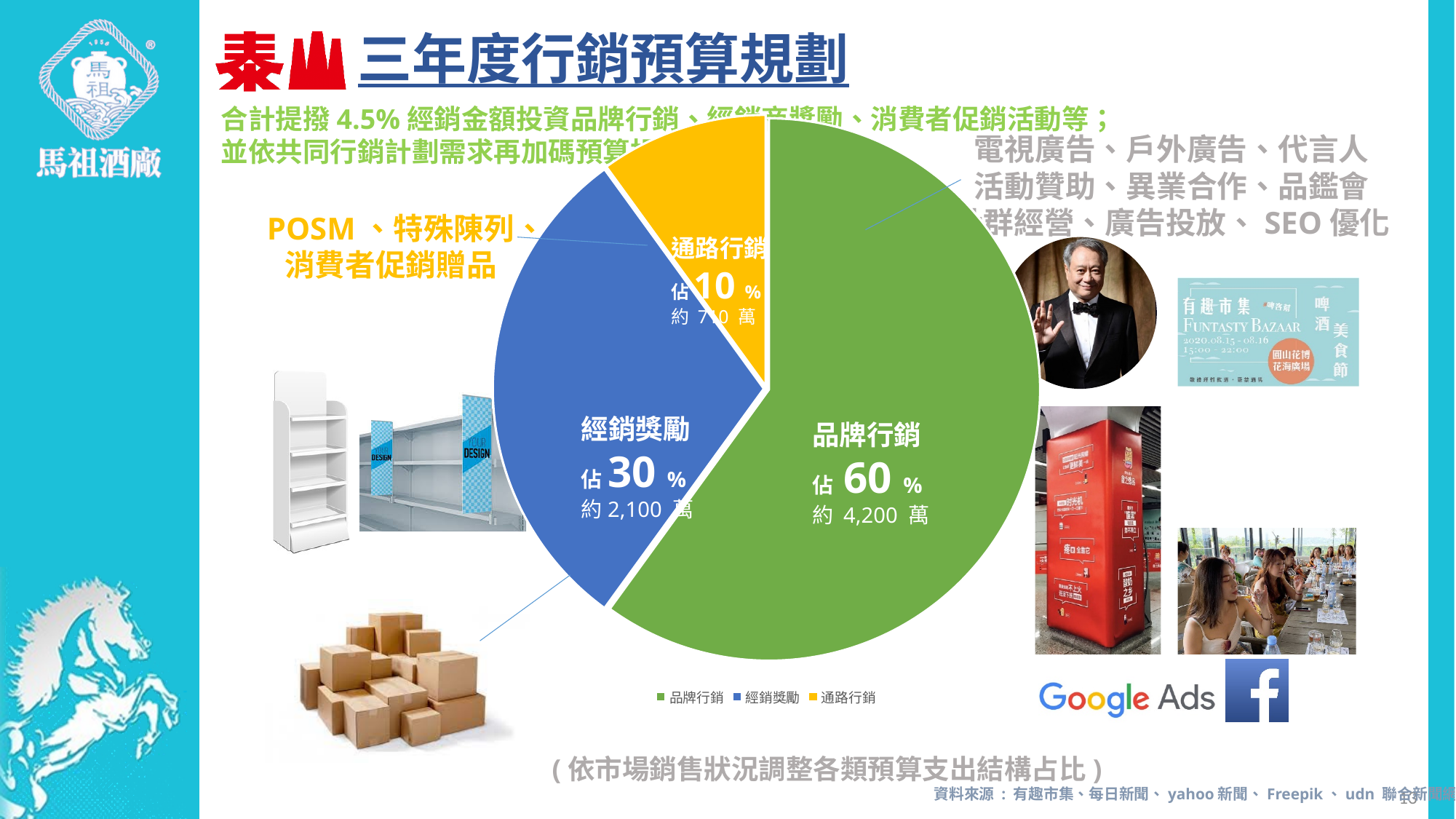
What percentage share does 經銷獎勵 have in the pie chart? 30% What percentage share does 通路行銷 have in the pie chart? 10% What approximate amount is labelled for 品牌行銷 in the pie chart? 約 4,200 萬 What percentage share does 品牌行銷 have in the pie chart? 60% Which category has the largest slice in the pie chart? 品牌行銷 Which slice is larger, 經銷獎勵 or 通路行銷? 經銷獎勵 How many percentage points larger is the 品牌行銷 share than the 經銷獎勵 share? 30 What approximate amount is labelled for 經銷獎勵 in the pie chart? 約 2,100 萬 What type of chart is shown on the slide? pie chart What colour is the 通路行銷 slice in the pie chart? yellow How many slices does the pie chart have? 3 Which category has the smallest slice in the pie chart? 通路行銷